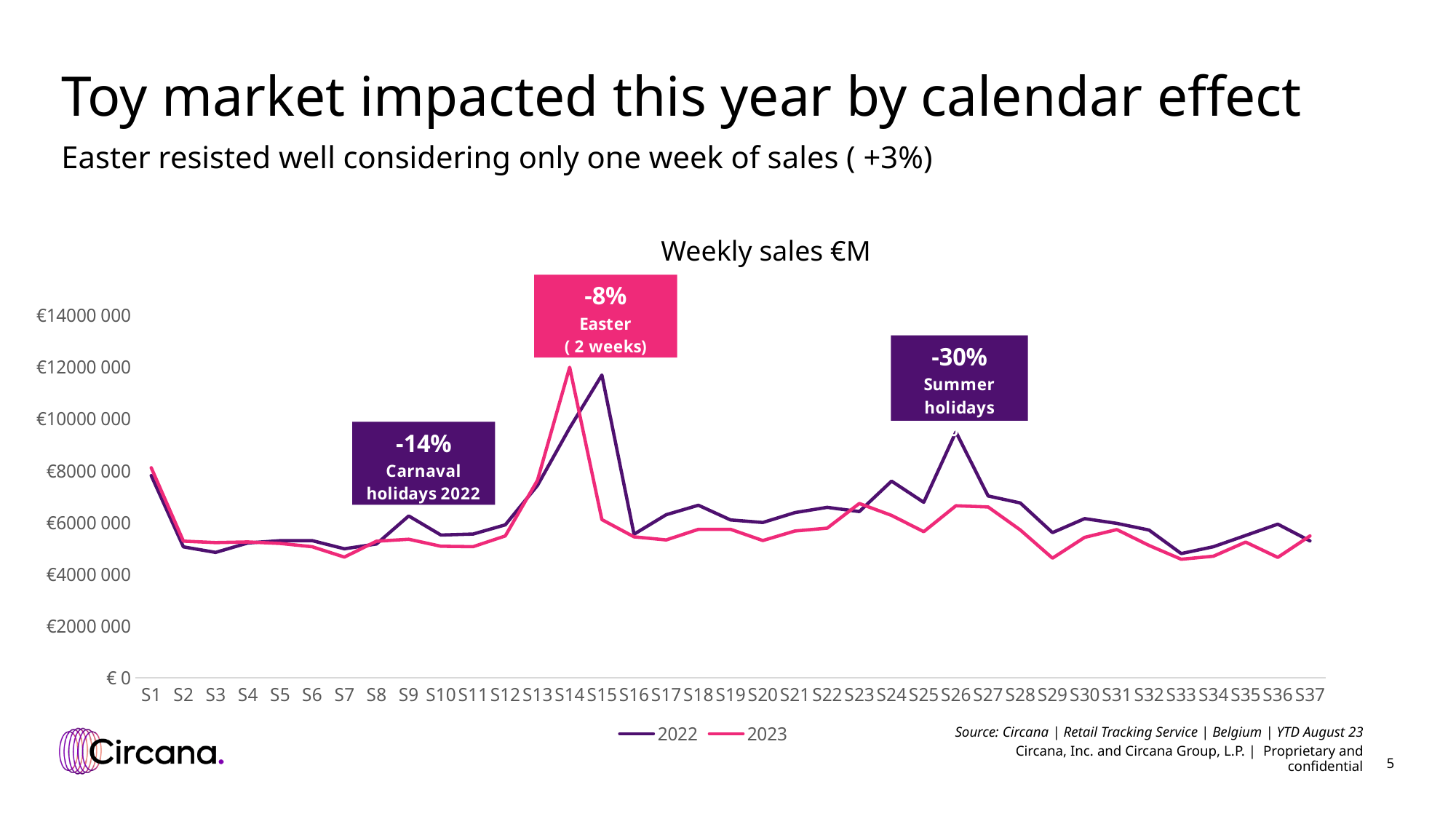
What kind of chart is shown on the slide? line chart Is the 2023 value for S7 greater or less than €6000 000? less At S14, which series has the larger value, 2022 or 2023? 2023 At S26, which series has the larger value, 2022 or 2023? 2022 What is the title of the chart? Weekly sales €M How many series does the legend list? 2 What percentage change is shown in the annotation for the Summer holidays? -30% How many weeks are plotted along the x axis? 37 In which week does the 2023 line reach its highest value? S14 Is the 2022 value for S15 greater or less than €10000 000? greater Is the 2022 value for S26 greater or less than €8000 000? greater In which week does the 2022 line reach its highest value? S15